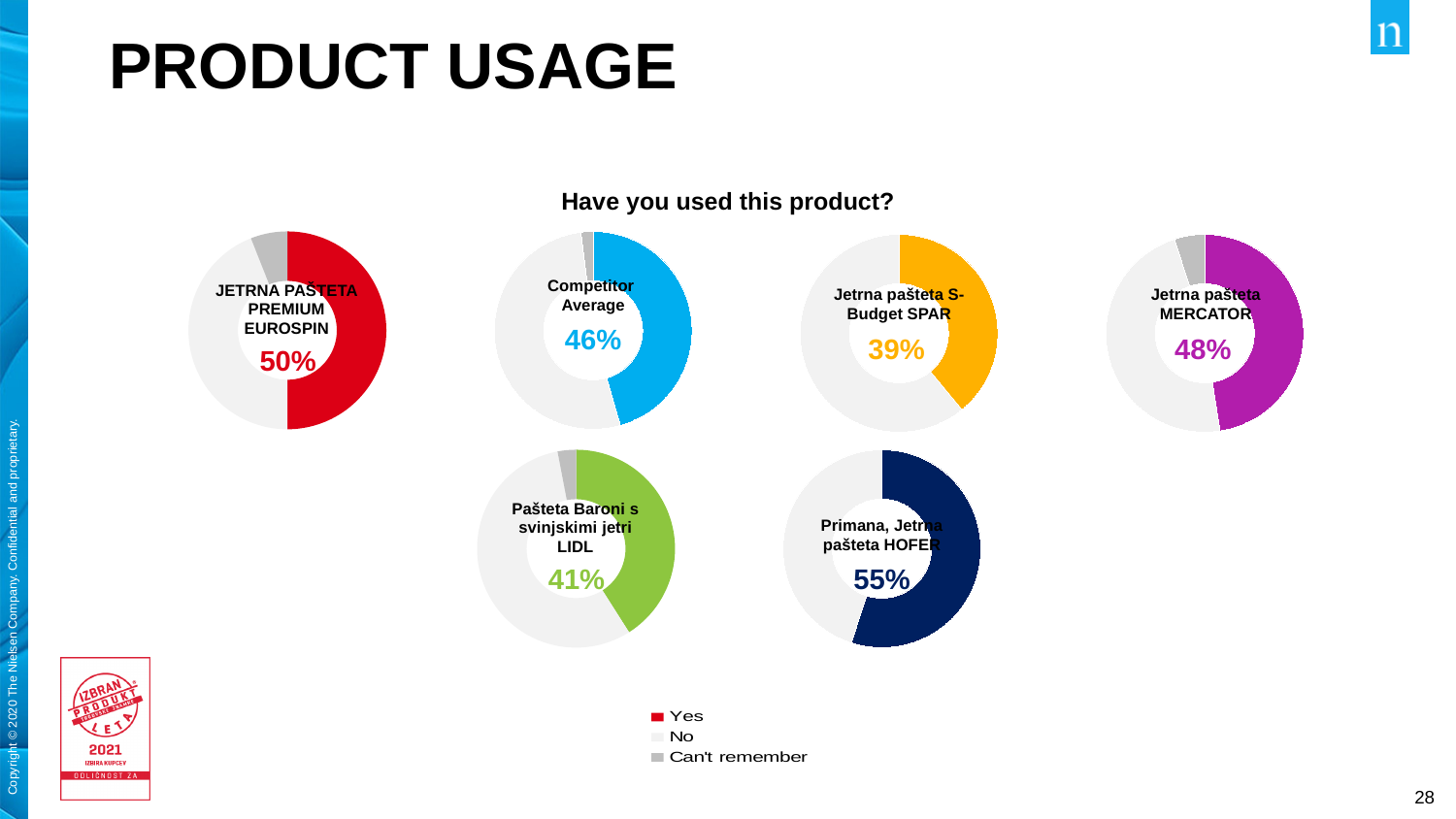
Across all the charts on the slide, which product has the lowest Yes percentage? Jetrna pašteta S-Budget SPAR In the Pašteta Baroni s svinjskimi jetri LIDL chart, what percentage is shown? 41% What kind of chart is used to show the product usage results on this slide? Donut (pie) chart What is the difference between the Yes percentage for Primana, Jetrna pašteta HOFER and the Competitor Average? 9% In the Primana, Jetrna pašteta HOFER chart, what percentage is shown? 55% How many entries does the legend on the slide list? 3 In the Jetrna pašteta S-Budget SPAR chart, what percentage is shown? 39% In the JETRNA PAŠTETA PREMIUM EUROSPIN chart, what percentage of respondents answered Yes? 50% Which has a higher Yes percentage: Jetrna pašteta MERCATOR or Pašteta Baroni s svinjskimi jetri LIDL? Jetrna pašteta MERCATOR In the Competitor Average chart, what percentage is shown for Yes? 46% In the Jetrna pašteta MERCATOR chart, what percentage is shown? 48% Across all the charts on the slide, which product has the highest Yes percentage? Primana, Jetrna pašteta HOFER